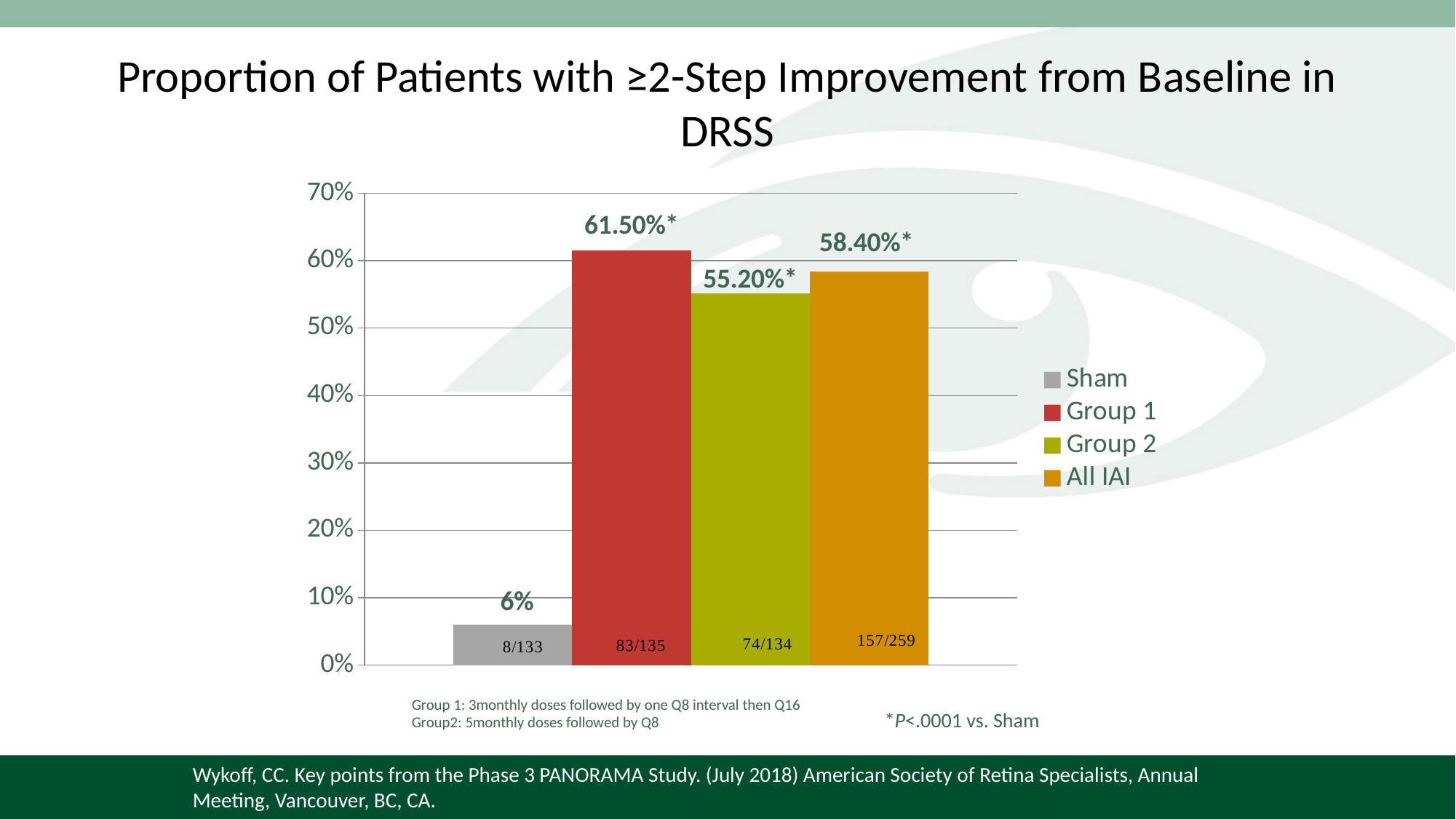
What fraction of patients is printed on the All IAI bar? 157/259 What is the value for Group 1? 61.50% How many bars are shown in the chart? 4 What kind of chart is shown on the slide? Bar chart What is the value for All IAI? 58.40% What is the value for Sham? 6% What is the difference between the values for Group 1 and Group 2? 6.30% Which is larger, the value for Group 2 or the value for All IAI? All IAI Which group has the lowest proportion of patients with ≥2-step improvement? Sham Which group has the highest proportion of patients with ≥2-step improvement? Group 1 Is the value for Group 2 greater or less than 50%? greater How many entries does the legend list? 4